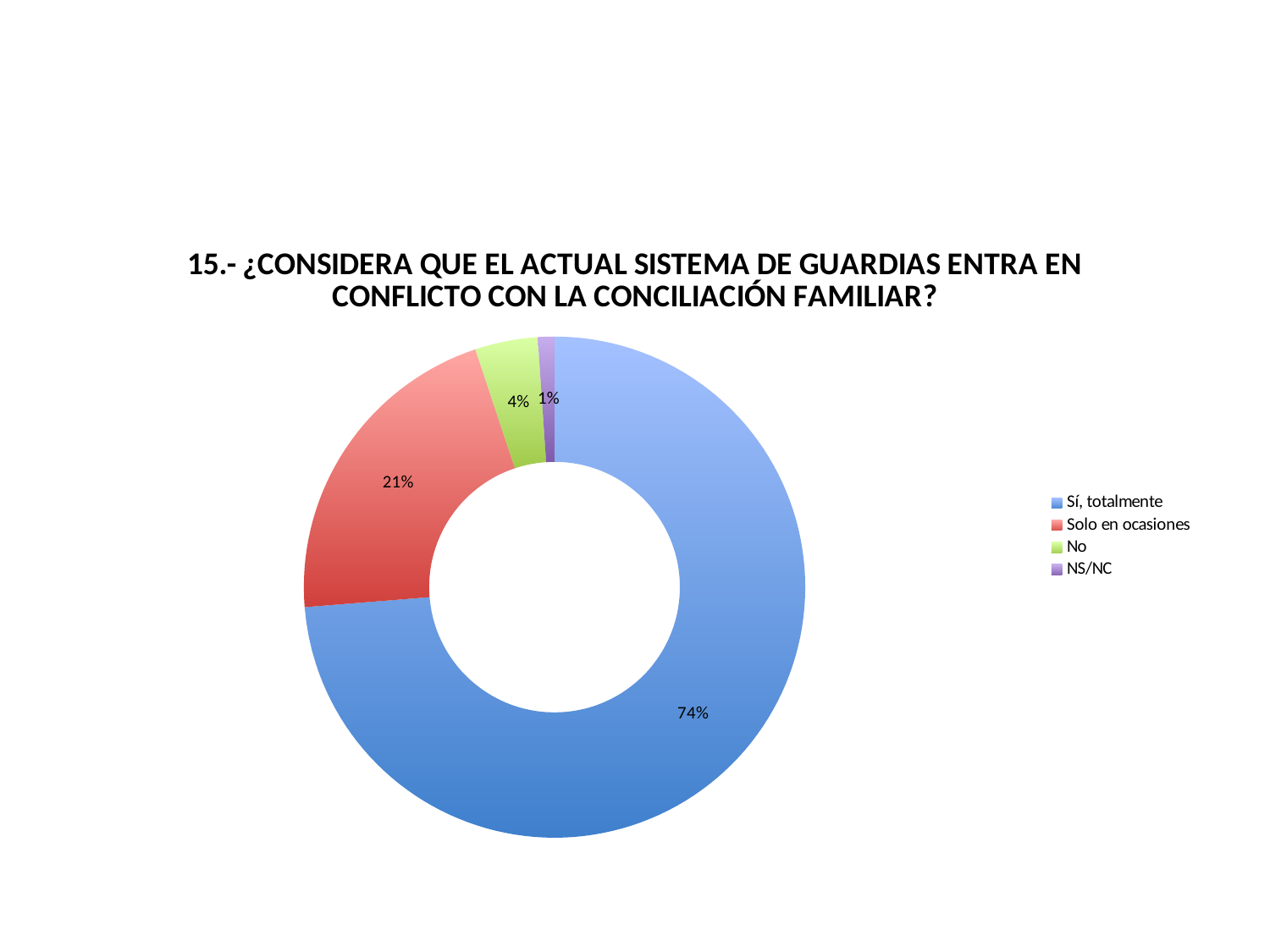
Which response category has the largest share of the chart? Sí, totalmente What is the difference in percentage points between "Sí, totalmente" and "Solo en ocasiones"? 53 Which is larger, the share for "No" or the share for "NS/NC"? No What colour represents "Solo en ocasiones" in the chart? Red How many response categories are shown in the chart? 4 What percentage of respondents answered "Solo en ocasiones"? 21% What percentage of respondents answered "Sí, totalmente"? 74% What percentage of respondents answered "NS/NC"? 1% Which response category has the smallest share of the chart? NS/NC What percentage of respondents answered "No"? 4% What is the combined share of "No" and "NS/NC"? 5% What kind of chart is shown on the slide? Pie chart (doughnut)